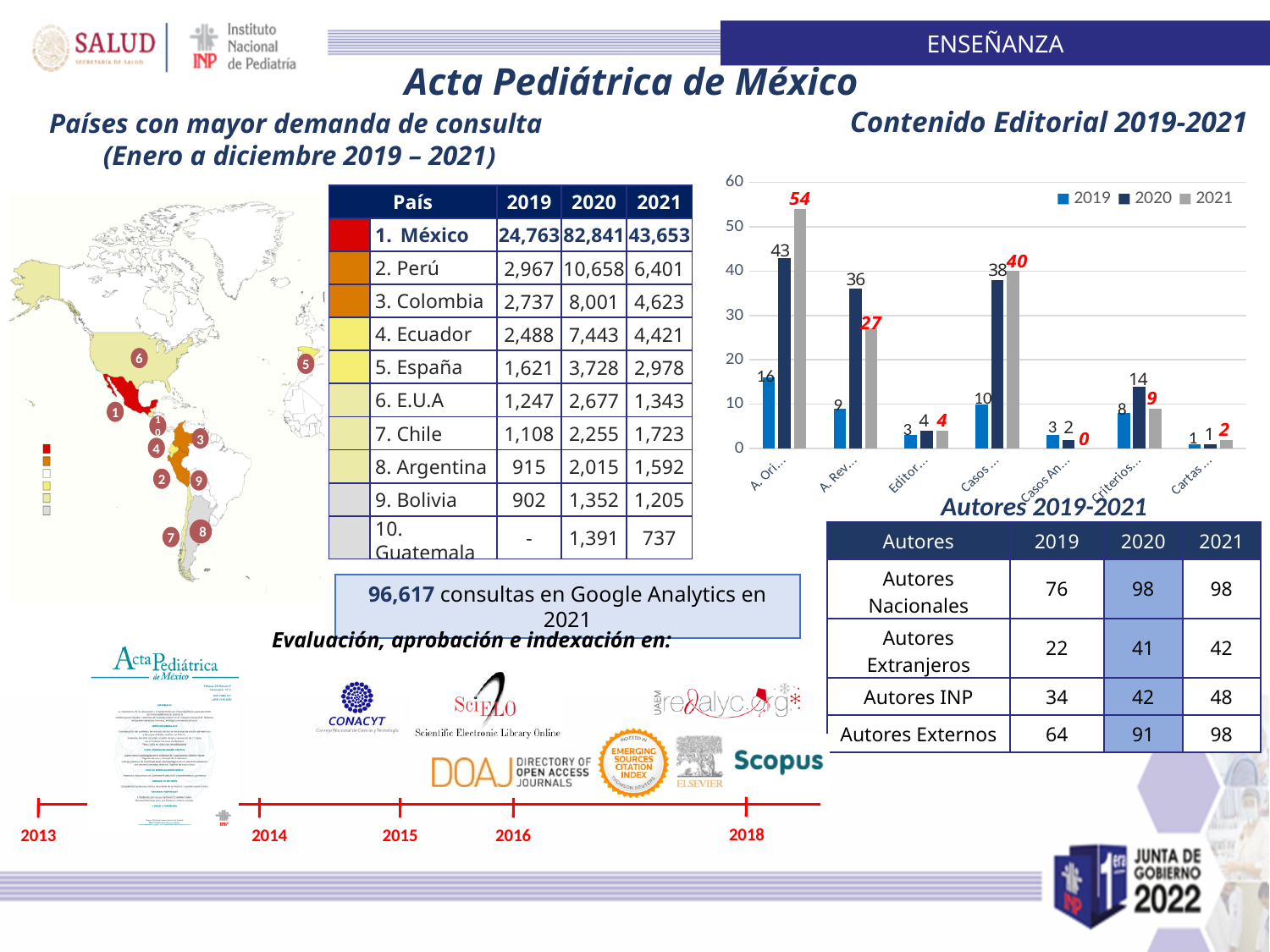
In the 'Contenido Editorial 2019-2021' chart, which category group has the highest 2021 value? A. Ori... (the first group) In the 'Contenido Editorial 2019-2021' chart, is the 2020 value for the fourth category group (Casos ...) greater or less than 30? greater In the 'Contenido Editorial 2019-2021' chart, what is the 2020 value for the second category group (A. Rev...)? 36 What kind of chart is shown under 'Contenido Editorial 2019-2021'? Bar chart In the 'Contenido Editorial 2019-2021' chart, what is the 2021 value for the first category group (A. Ori...)? 54 What are the legend entries of the 'Contenido Editorial 2019-2021' chart? 2019, 2020, 2021 In the 'Contenido Editorial 2019-2021' chart, what is the 2021 value for the fifth category group (Casos An...)? 0 In the 'Contenido Editorial 2019-2021' chart, what is the difference between the 2020 and 2019 values for the first category group (A. Ori...)? 27 How many category groups are plotted on the x axis of the 'Contenido Editorial 2019-2021' chart? 7 In the 'Contenido Editorial 2019-2021' chart, what is the difference between the 2021 and 2020 values for the fourth category group (Casos ...)? 2 How many series does the legend of the 'Contenido Editorial 2019-2021' chart list? 3 In the 'Contenido Editorial 2019-2021' chart, for the second category group (A. Rev...), which is larger: the 2020 value or the 2021 value? 2020